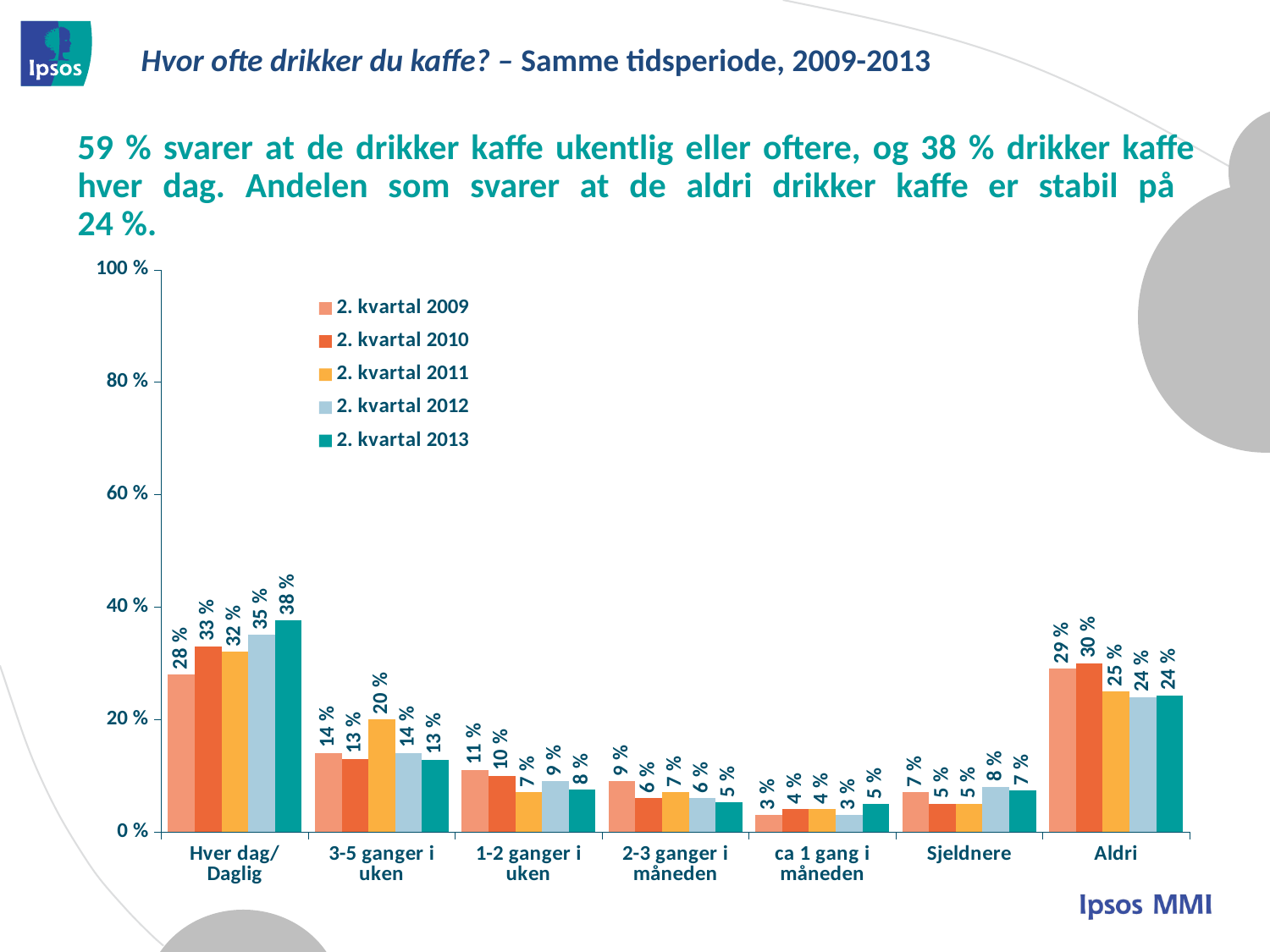
What kind of chart is shown on the slide? Bar chart Is the '2. kvartal 2011' value for 'Aldri' greater or less than 20 %? greater Which is larger for 'Aldri': the '2. kvartal 2010' value or the '2. kvartal 2012' value? 2. kvartal 2010 Which category has the lowest value in the '2. kvartal 2009' series? ca 1 gang i måneden What is the value for 'Aldri' in the '2. kvartal 2009' series? 29 % Do the values for 'Hver dag/ Daglig' rise or fall from '2. kvartal 2012' to '2. kvartal 2013'? Rise Which category has the highest value in the '2. kvartal 2013' series? Hver dag/ Daglig How many categories are shown on the x axis? 7 What is the value for '3-5 ganger i uken' in the '2. kvartal 2011' series? 20 % How many series does the legend list? 5 What is the difference between the '2. kvartal 2013' and '2. kvartal 2009' values for 'Hver dag/ Daglig'? 10 % What is the value for 'Hver dag/ Daglig' in the '2. kvartal 2013' series? 38 %